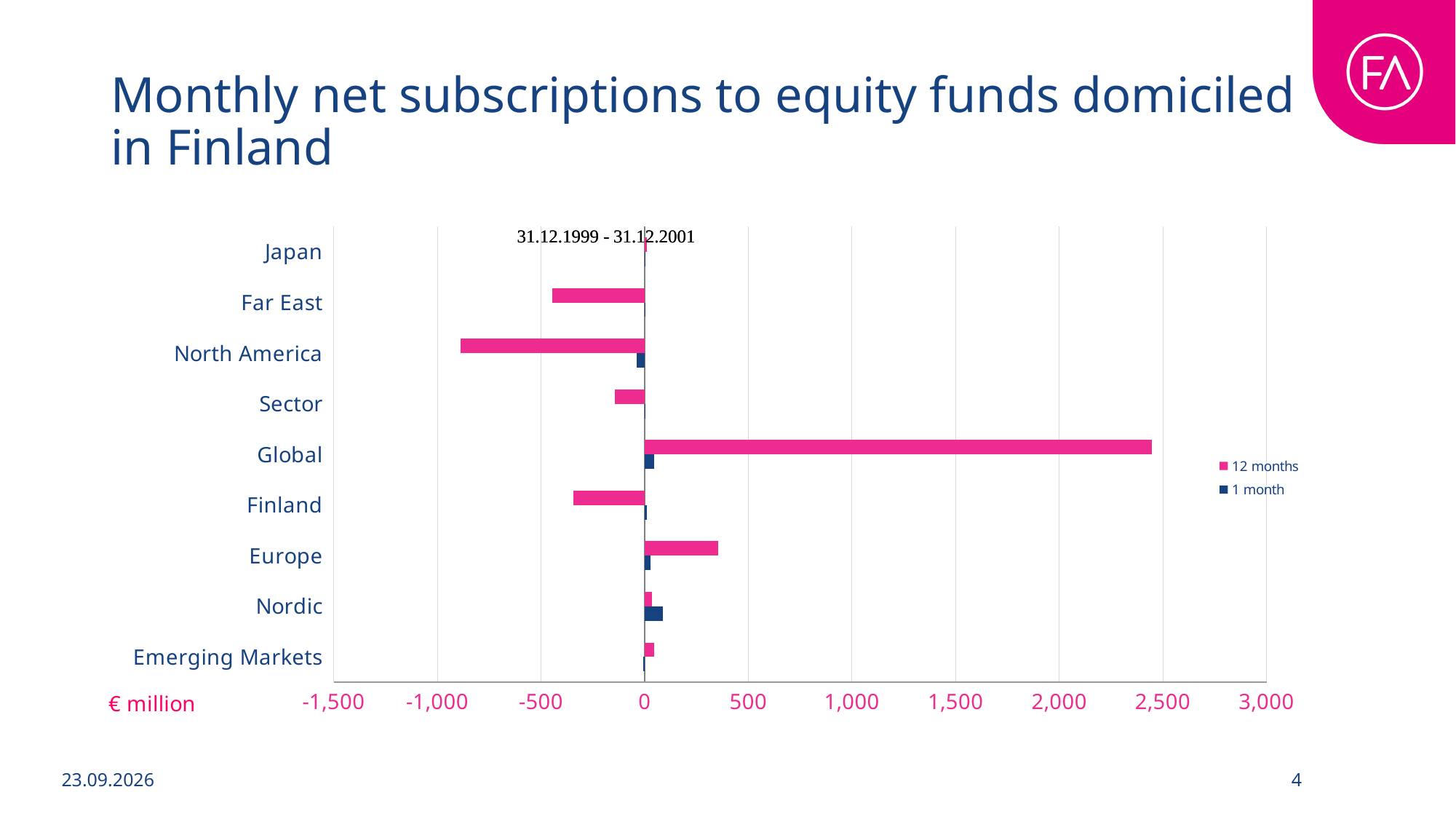
What kind of chart is shown on the slide? bar chart Which colour represents the 12 months series in the chart? pink Is the 12 months value for Global greater or less than 2,000? greater How many series does the chart's legend list? 2 Which has the larger 12 months value, Europe or Finland? Europe How many categories are listed on the vertical axis of the chart? 9 Which has the larger 1 month value, Nordic or Global? Nordic Which category has the highest 12 months value? Global Which category has the lowest 12 months value? North America What unit is shown for the horizontal axis of the chart? € million Is the 12 months value for North America greater or less than -500? less Is the 12 months value for Europe greater or less than 500? less